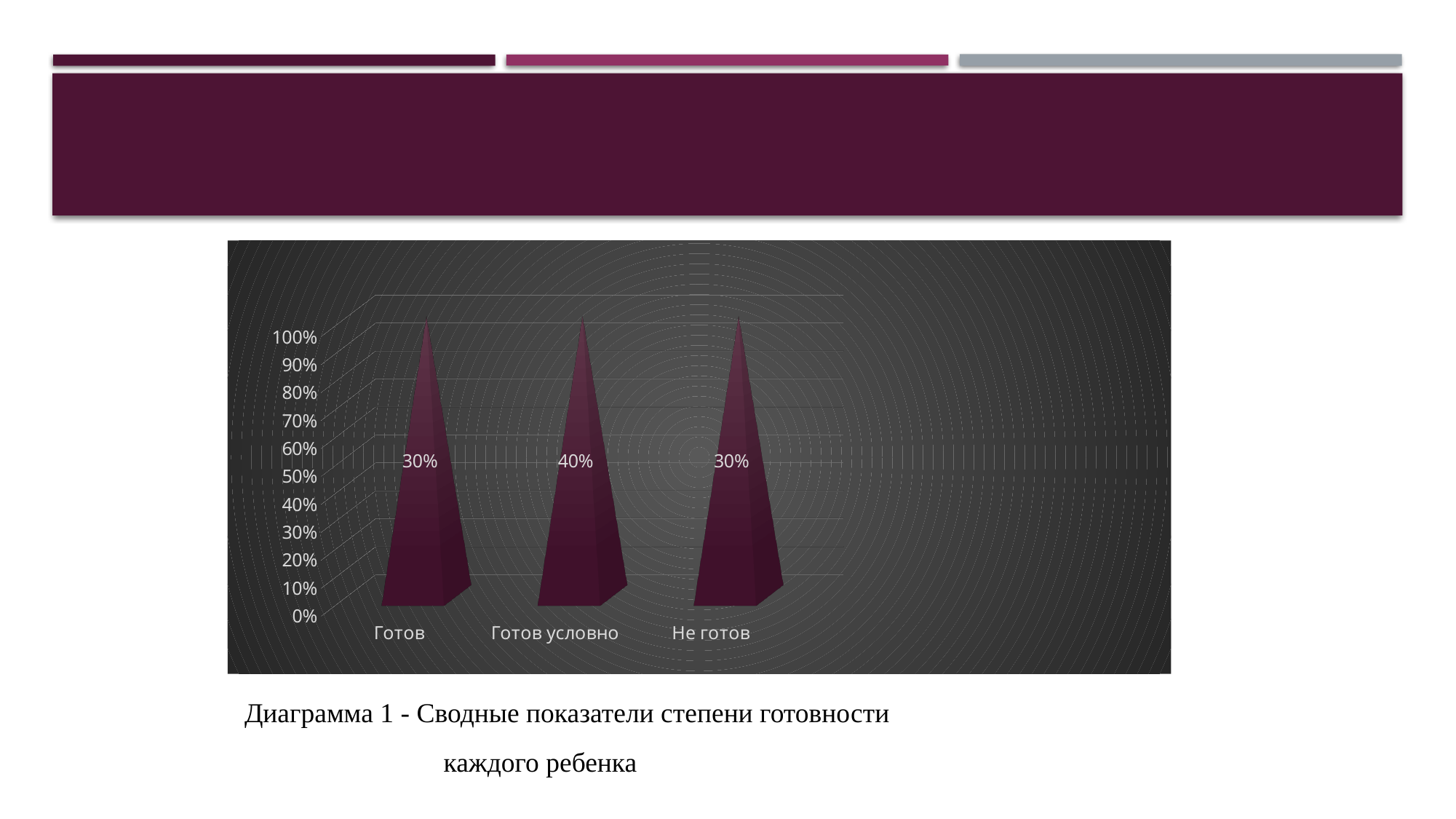
What is the difference between the values for Готов условно and Готов? 10% What is the difference between the values for Готов условно and Не готов? 10% What is the highest tick label shown on the vertical axis? 100% What is the value for Не готов? 30% What is the value for Готов условно? 40% What is the caption printed below the chart? Диаграмма 1 - Сводные показатели степени готовности каждого ребенка What is the value for Готов? 30% How many categories are shown on the x axis? 3 Which category has the highest value? Готов условно What kind of chart is shown on the slide? bar chart What is the total of the three values shown in the chart? 100% Which is larger, the value for Готов условно or the value for Не готов? Готов условно